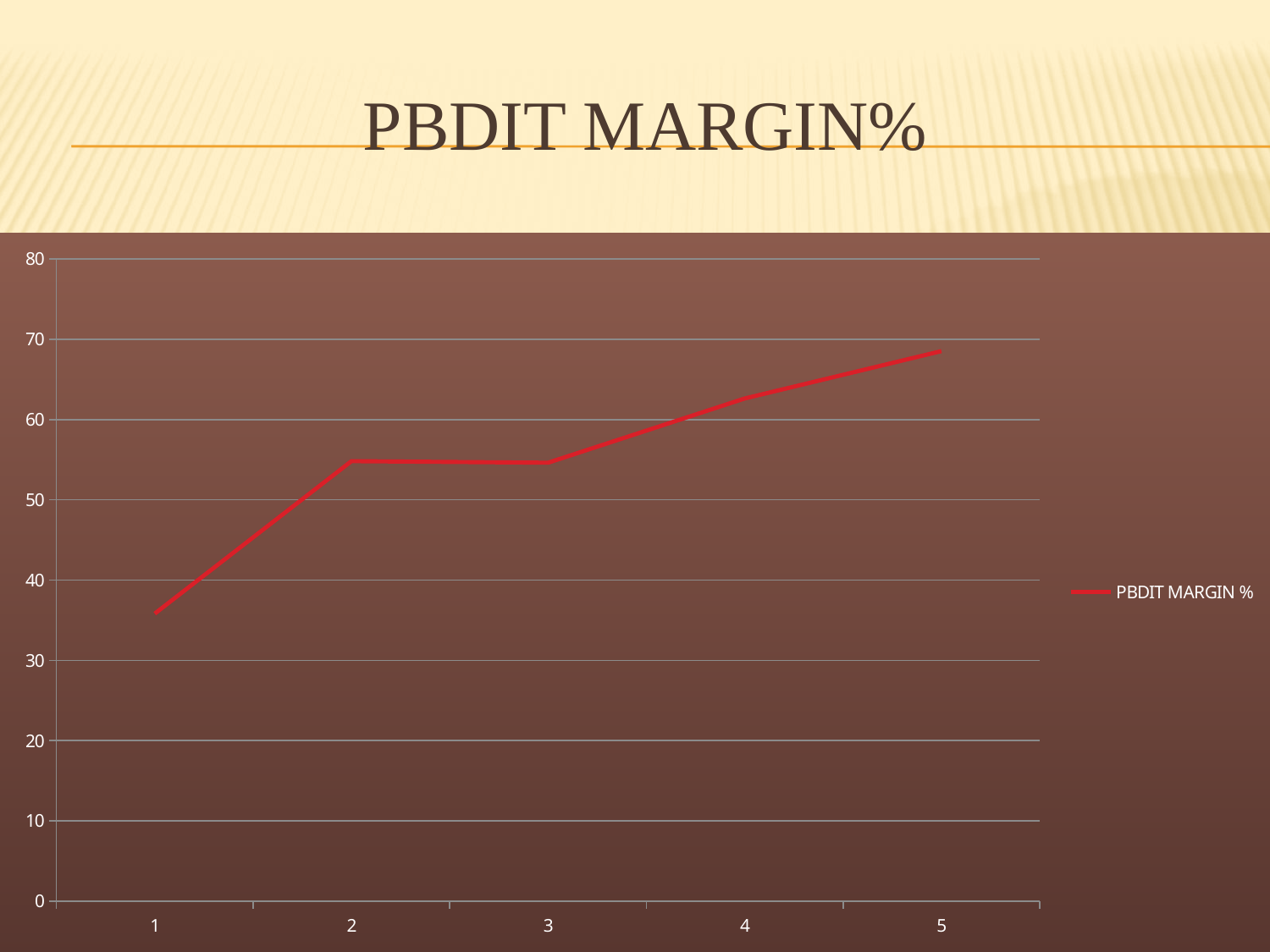
Does the PBDIT MARGIN % value generally rise or fall from point 1 to point 5? rise At which x-axis point is the PBDIT MARGIN % value lowest? 1 What kind of chart is shown on the slide? line chart What is the name of the series shown in the legend? PBDIT MARGIN % How many points are plotted on the PBDIT MARGIN % line? 5 Which has a larger PBDIT MARGIN % value, point 1 or point 2? point 2 How many series does the legend list? 1 Is the PBDIT MARGIN % value at point 5 greater or less than 60? greater Is the PBDIT MARGIN % value at point 2 greater or less than 50? greater Is the PBDIT MARGIN % value at point 1 greater or less than 40? less What is the title of the chart? PBDIT MARGIN% At which x-axis point is the PBDIT MARGIN % value highest? 5